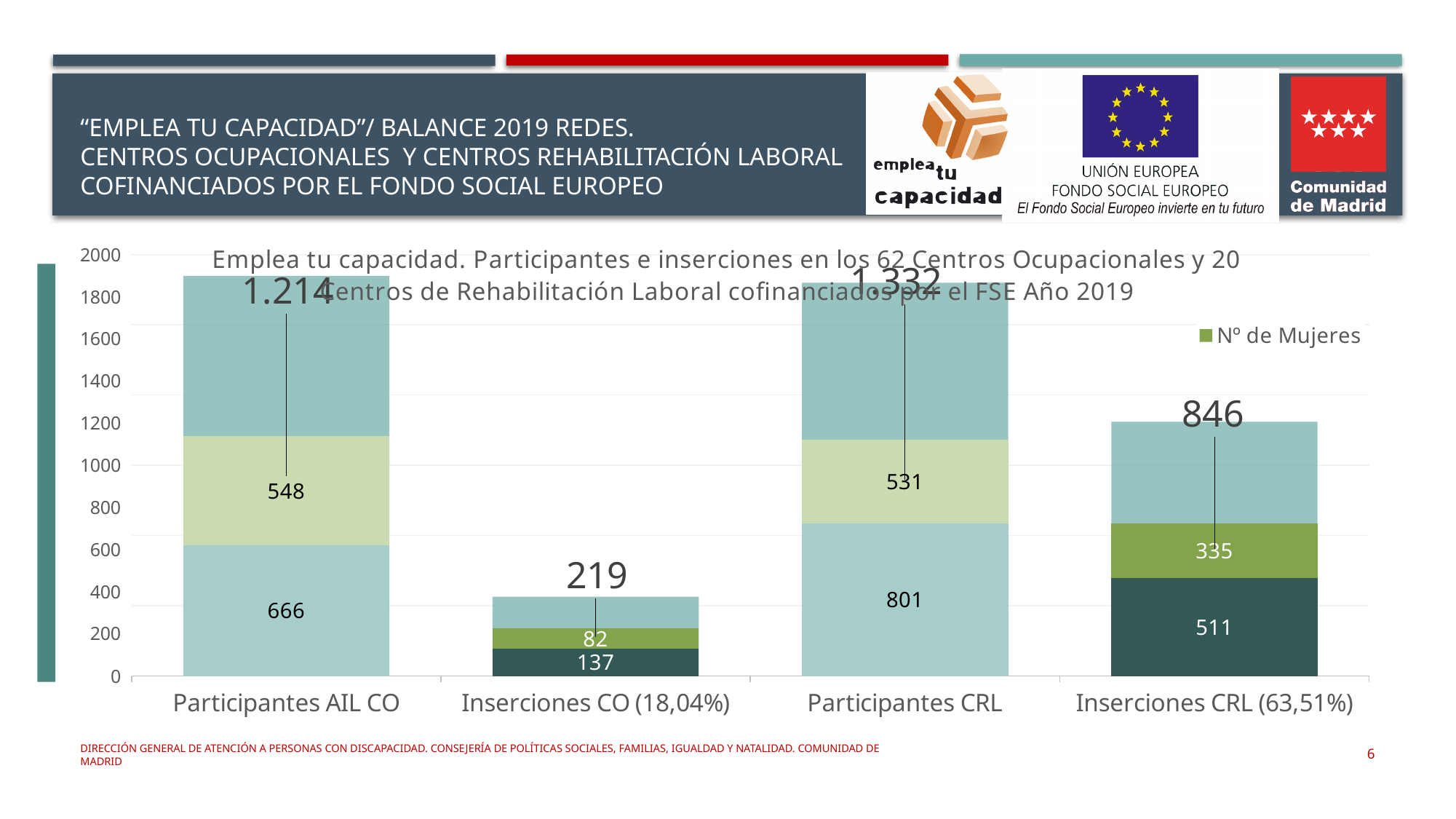
What is the difference between the bottom segment (666) and the middle segment (548) of the Participantes AIL CO bar? 118 What is the total value labelled above the bar for Inserciones CO (18,04%)? 219 What is the value of the bottom segment of the Participantes CRL bar? 801 What is the value of the middle segment of the Inserciones CRL (63,51%) bar? 335 Which category has the highest total value labelled above its bar? Participantes CRL What kind of chart is shown on the slide? bar chart What is the total value labelled above the bar for Participantes CRL? 1.332 Which category has the lowest total value labelled above its bar? Inserciones CO (18,04%) Which legend entry is shown on the chart? Nº de Mujeres What is the total value labelled above the bar for Participantes AIL CO? 1.214 How many categories are shown on the x axis of the chart? 4 What is the total value labelled above the bar for Inserciones CRL (63,51%)? 846